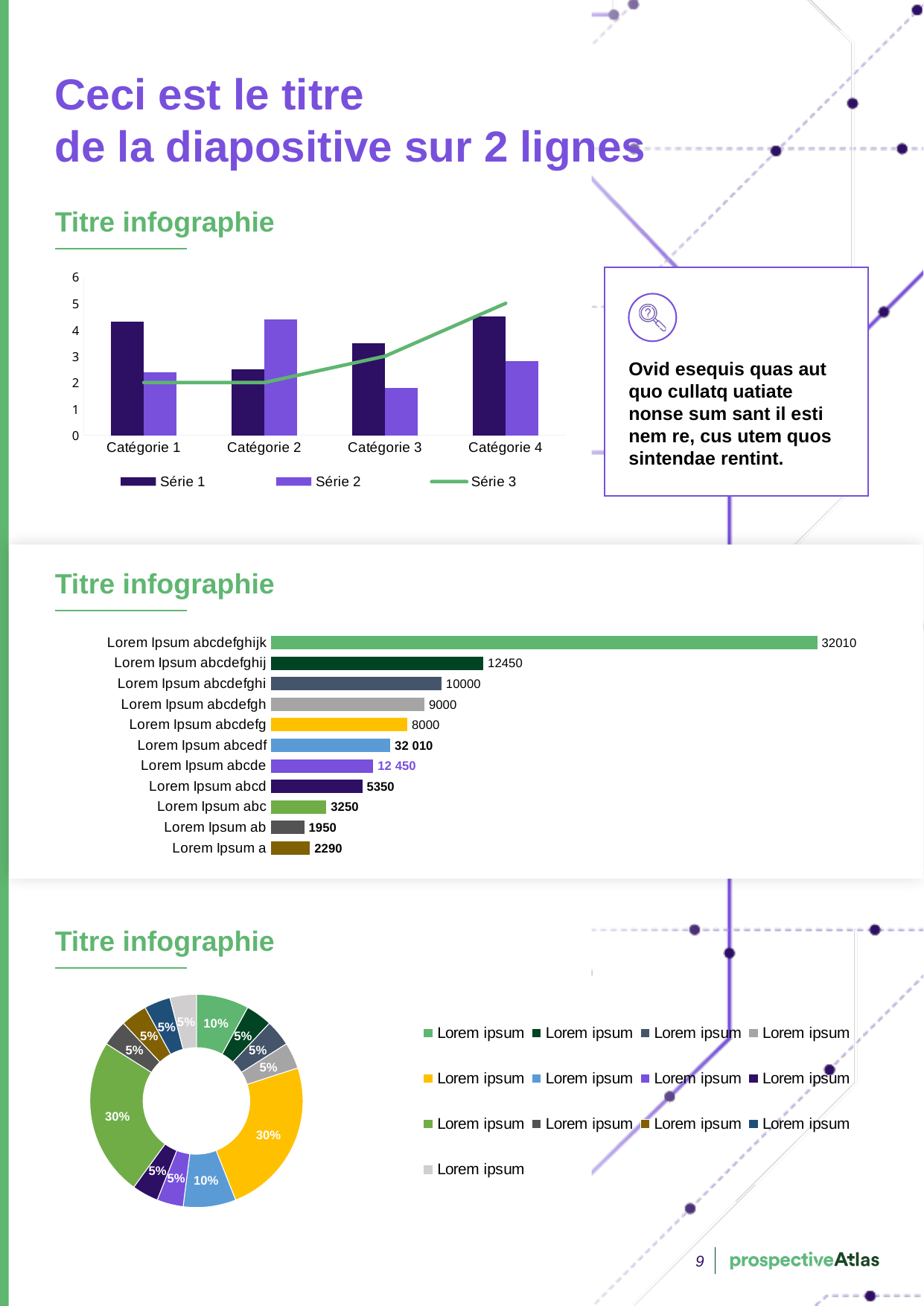
In the bottom chart, what share does the yellow slice represent? 30% In the top chart, is the value of Série 1 for Catégorie 1 greater or less than 4? greater How many bars are shown in the middle chart? 11 In the top chart, which is larger for Catégorie 2: Série 1 or Série 2? Série 2 How many series does the legend of the top chart list? 3 In the middle chart, what is the value for Lorem Ipsum abcd? 5350 In the middle chart, what is the value for Lorem Ipsum abcdefghi? 10000 In the top chart, is the value of Série 2 for Catégorie 3 greater or less than 2? less In the middle chart, what is the difference between the values for Lorem Ipsum abcdefghi and Lorem Ipsum abcdefgh? 1000 In the top chart, does the Série 3 line rise or fall from Catégorie 2 to Catégorie 4? rises What type of chart is the top chart on the slide? Combined bar and line chart How many categories are shown on the x axis of the top chart? 4